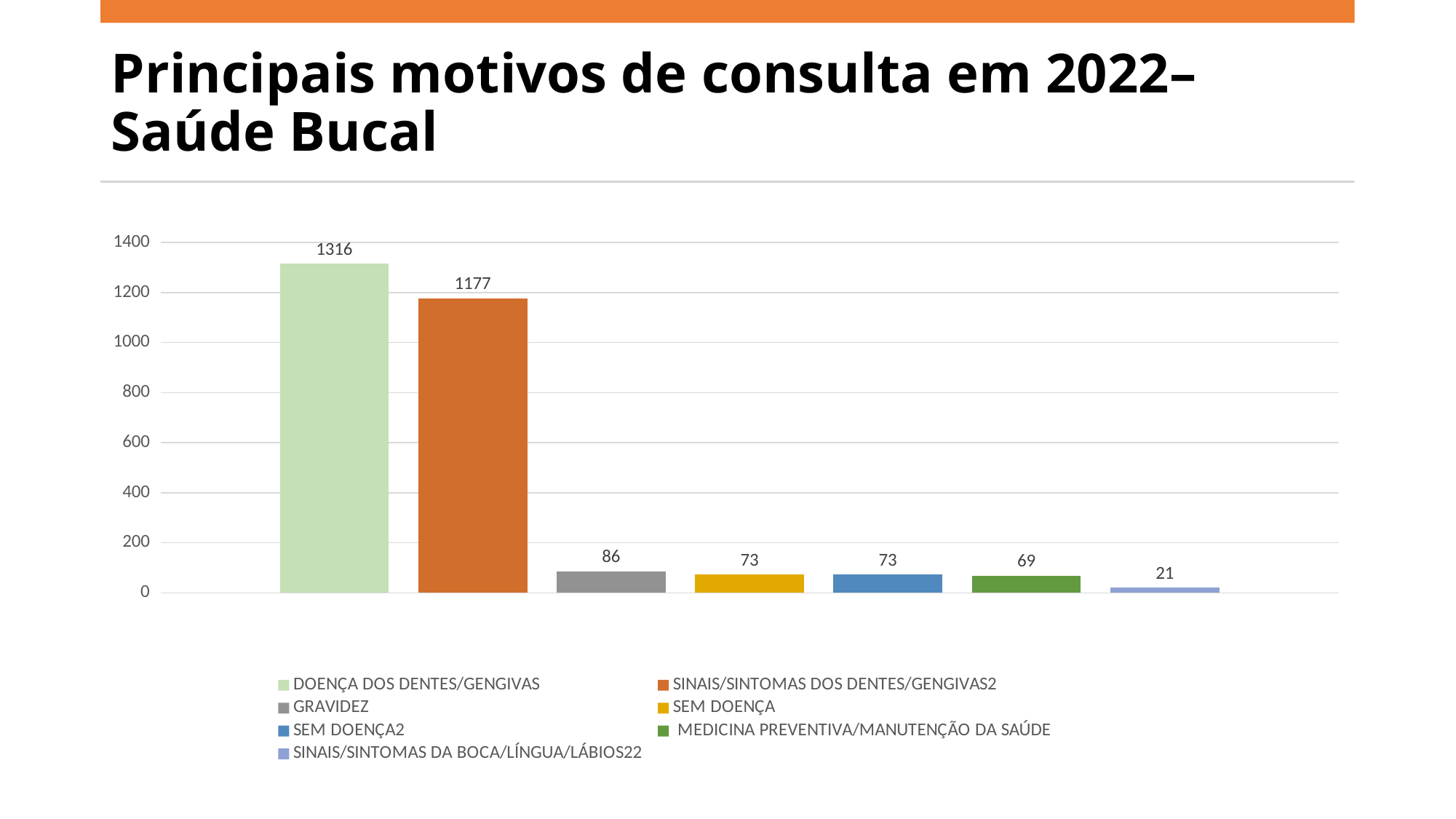
Which category has the lowest value? SINAIS/SINTOMAS DA BOCA/LÍNGUA/LÁBIOS22 What colour is the bar for SEM DOENÇA? yellow How many categories are shown in the chart? 7 What is the value for DOENÇA DOS DENTES/GENGIVAS? 1316 Is the value for SINAIS/SINTOMAS DOS DENTES/GENGIVAS2 greater or less than 1000? greater Which category has the highest value? DOENÇA DOS DENTES/GENGIVAS What is the value for GRAVIDEZ? 86 What is the difference between the values for DOENÇA DOS DENTES/GENGIVAS and SINAIS/SINTOMAS DOS DENTES/GENGIVAS2? 139 Which is larger, the value for GRAVIDEZ or the value for MEDICINA PREVENTIVA/MANUTENÇÃO DA SAÚDE? GRAVIDEZ What kind of chart is shown on the slide? bar chart What is the value for SINAIS/SINTOMAS DOS DENTES/GENGIVAS2? 1177 What is the value for SINAIS/SINTOMAS DA BOCA/LÍNGUA/LÁBIOS22? 21